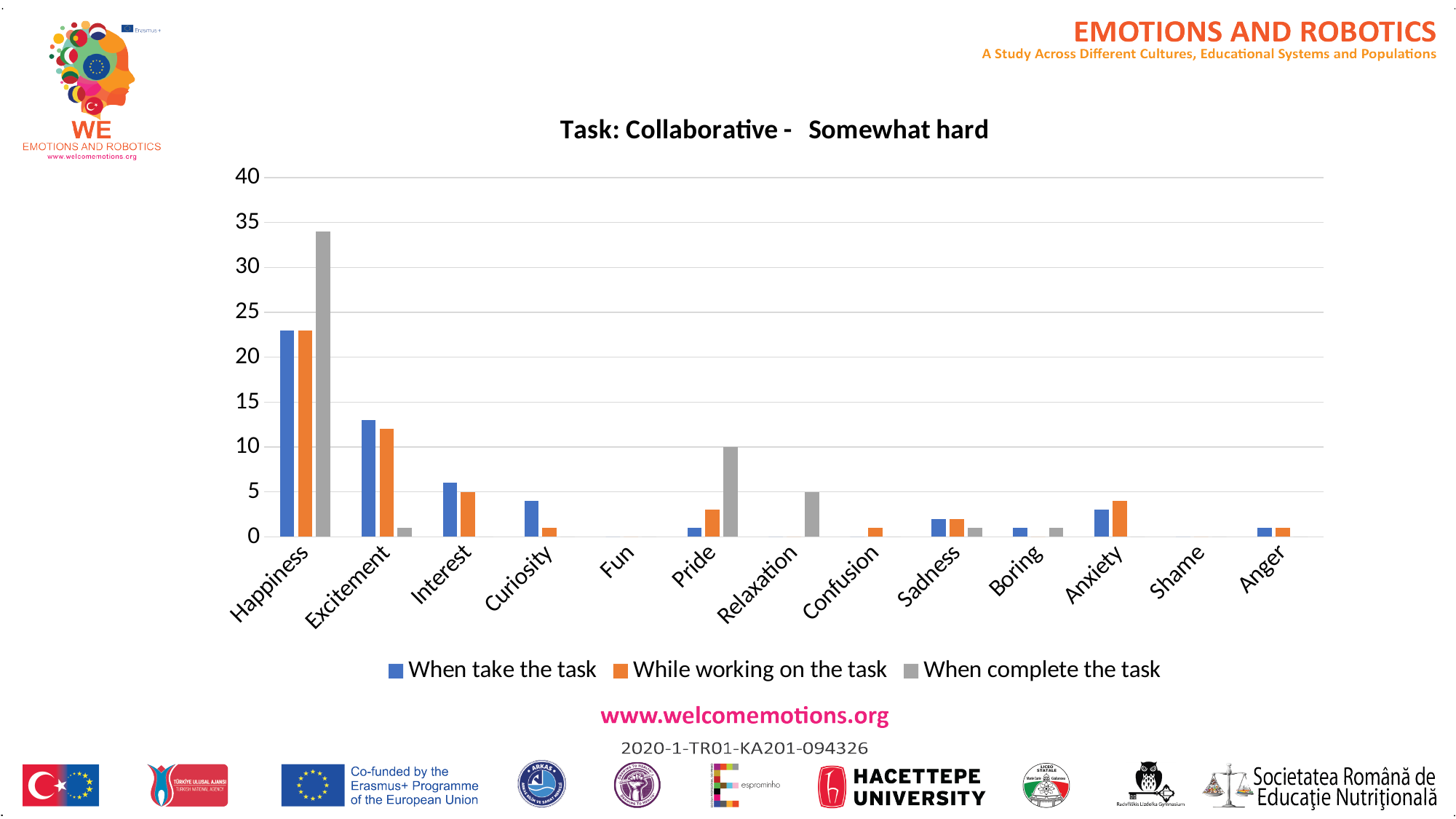
Which colour represents 'While working on the task' in the legend? orange Is the value for Happiness in 'When complete the task' greater or less than 30? greater Which emotion has the highest value for 'When complete the task'? Happiness For Pride, which is larger: 'When complete the task' or 'When take the task'? When complete the task How many series does the legend list? 3 What kind of chart is shown on the slide? bar chart Which emotion has the highest value for 'When take the task'? Happiness How many emotion categories are shown on the x axis? 13 What is the title of the chart? Task: Collaborative - Somewhat hard Is the value for Excitement in 'When take the task' greater or less than 10? greater For Excitement, which is larger: 'When take the task' or 'When complete the task'? When take the task Is the value for Happiness in 'When take the task' greater or less than 20? greater